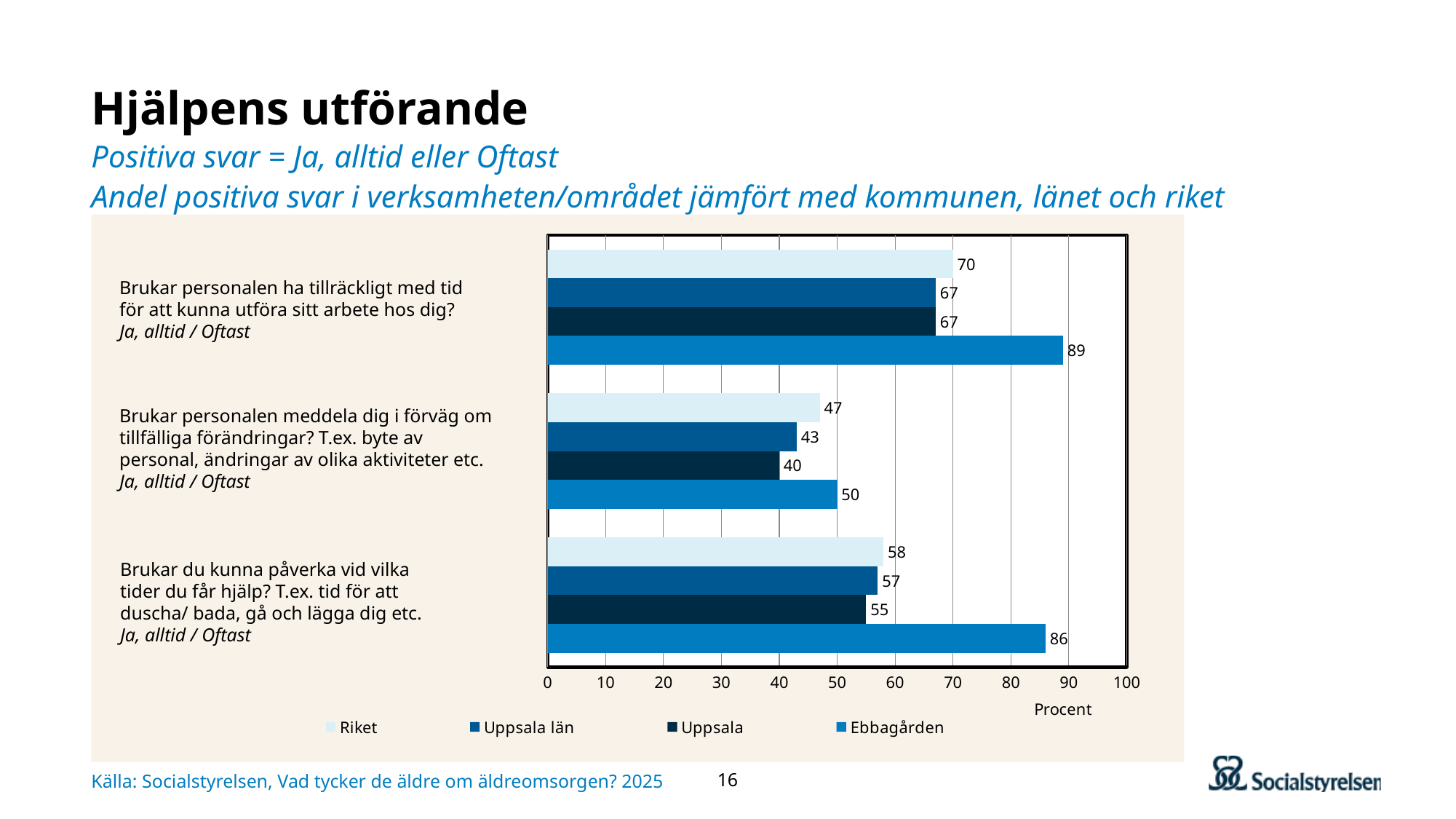
Which series has the highest value on the question "Brukar du kunna påverka vid vilka tider du får hjälp?"? Ebbagården Which is larger on the question "Brukar personalen meddela dig i förväg om tillfälliga förändringar?": Riket or Uppsala län? Riket What is the value for Ebbagården on the question "Brukar personalen ha tillräckligt med tid för att kunna utföra sitt arbete hos dig?"? 89 What unit is shown on the horizontal axis of the chart? Procent Which series has the lowest value on the question "Brukar personalen meddela dig i förväg om tillfälliga förändringar?"? Uppsala What is the value for Uppsala on the question "Brukar du kunna påverka vid vilka tider du får hjälp?"? 55 How many series does the legend list? 4 What kind of chart is shown on the slide? Bar chart What is the difference between Ebbagården and Uppsala on the question "Brukar du kunna påverka vid vilka tider du får hjälp?"? 31 What is the value for Riket on the question "Brukar personalen meddela dig i förväg om tillfälliga förändringar?"? 47 What is the difference between Ebbagården and Riket on the question "Brukar personalen ha tillräckligt med tid för att kunna utföra sitt arbete hos dig?"? 19 How many question categories are shown in the chart? 3